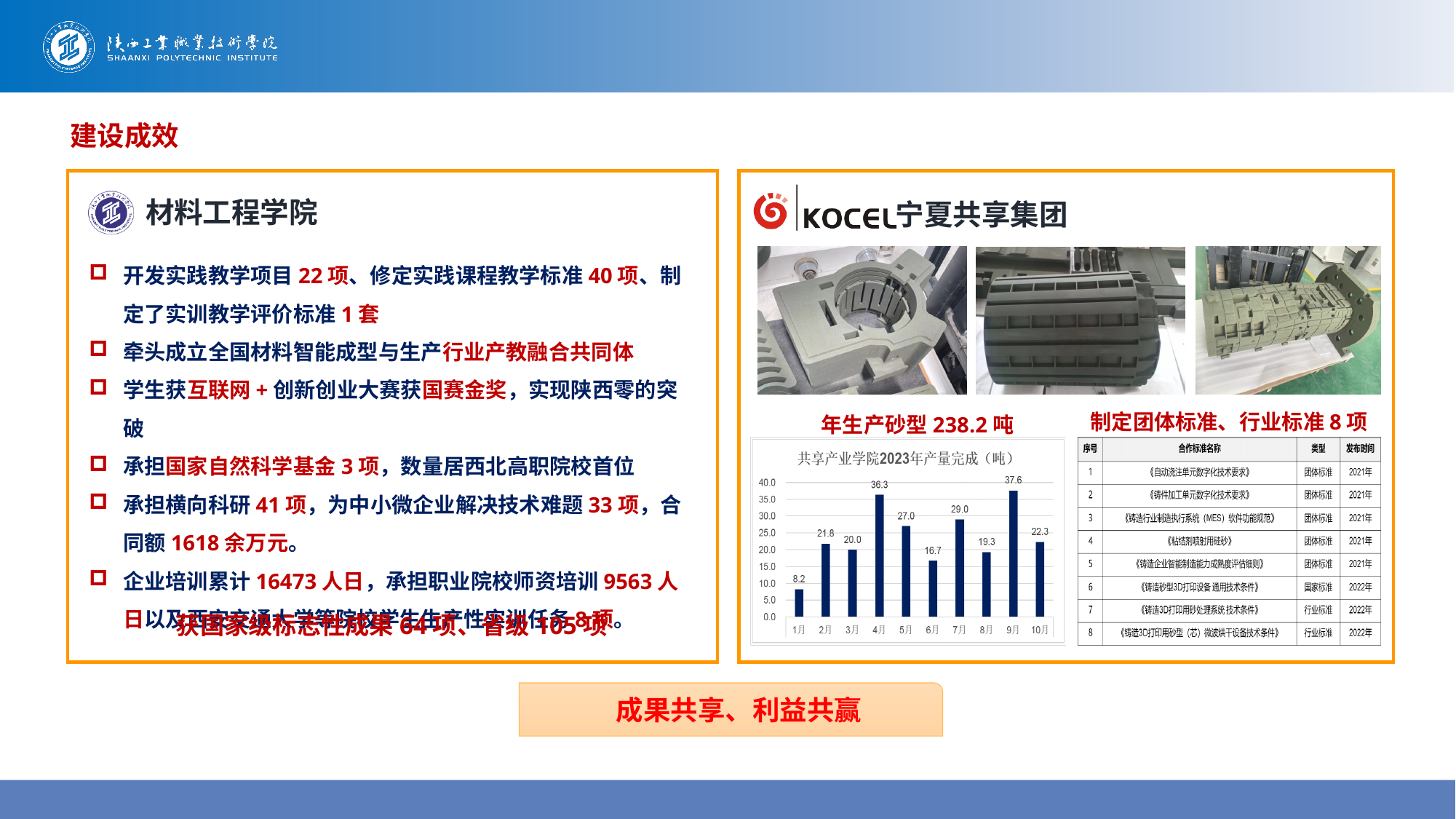
Which is larger, the value for 5月 or the value for 6月? 5月 Which month has the lowest value in the chart? 1月 What is the value for 4月 in the chart? 36.3 What is the value for 1月 in the chart? 8.2 What is the value for 7月 in the chart? 29.0 What is the difference between the values for 9月 and 4月? 1.3 What is the difference between the values for 2月 and 3月? 1.8 What type of chart is used to show the 2023 monthly output? bar chart Which month has the highest value in the chart? 9月 How many months are plotted in the chart? 10 What is the title of the bar chart on the slide? 共享产业学院2023年产量完成（吨） Is the value for 8月 greater or less than 20.0? less